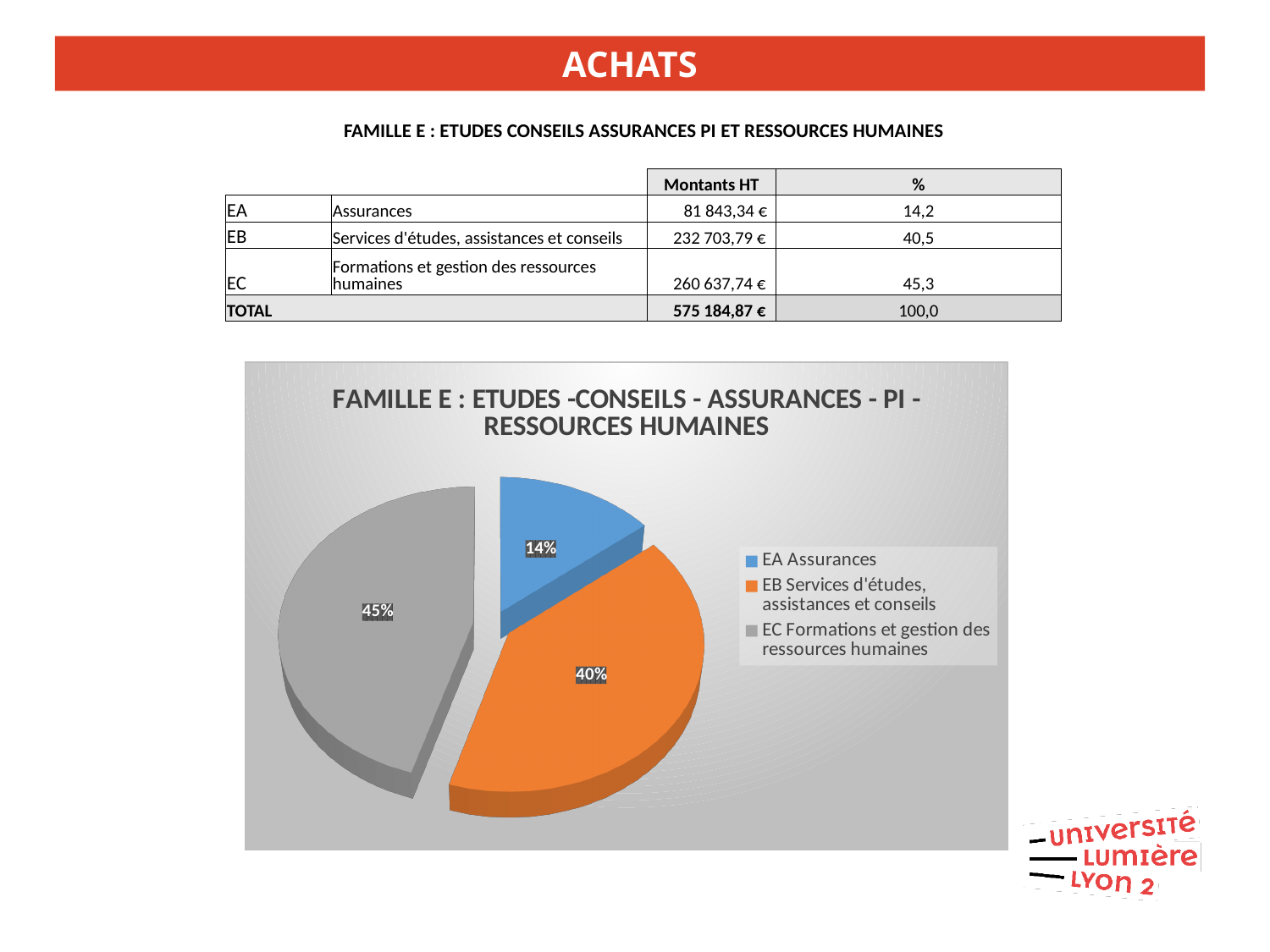
What share of the pie does EB Services d'études, assistances et conseils represent? 40% Which slice is larger, EB Services d'études, assistances et conseils or EC Formations et gestion des ressources humaines? EC Formations et gestion des ressources humaines What is the difference in percentage points between the EC slice and the EA slice? 31 What kind of chart is shown on the slide? Pie chart How many entries does the chart legend list? 3 What share of the pie does EC Formations et gestion des ressources humaines represent? 45% How many slices does the pie chart have? 3 What colour is the EB Services d'études, assistances et conseils slice? Orange Which category has the largest slice of the pie? EC Formations et gestion des ressources humaines What is the difference in percentage points between the EC slice and the EB slice? 5 Which category has the smallest slice of the pie? EA Assurances What share of the pie does EA Assurances represent? 14%